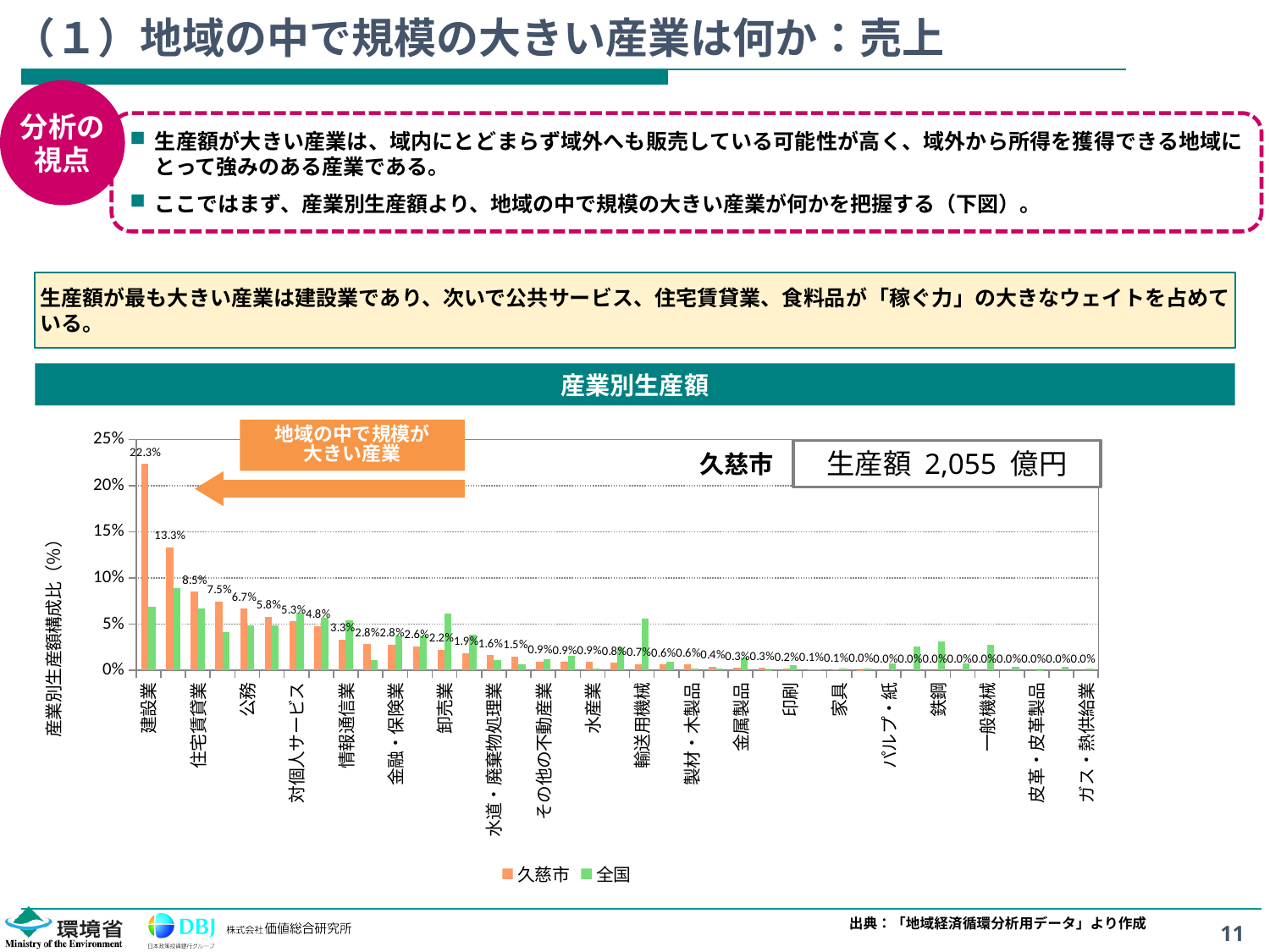
What is the difference between the 久慈市 values for 建設業 and 住宅賃貸業? 13.8 percentage points What is the 久慈市 value for 住宅賃貸業? 8.5% How many series does the legend list? 2 For 建設業, which series has the larger value, 久慈市 or 全国? 久慈市 Which industry has the highest 久慈市 value? 建設業 What is the 久慈市 value for 公務? 6.7% What kind of chart is shown on the slide? bar chart Do the 久慈市 values rise or fall moving from left to right along the x axis? fall For 卸売業, which series has the larger value, 久慈市 or 全国? 全国 What is the 久慈市 value for 建設業? 22.3% What are the two series named in the legend? 久慈市 and 全国 Is the 全国 value for 建設業 greater or less than 5%? greater